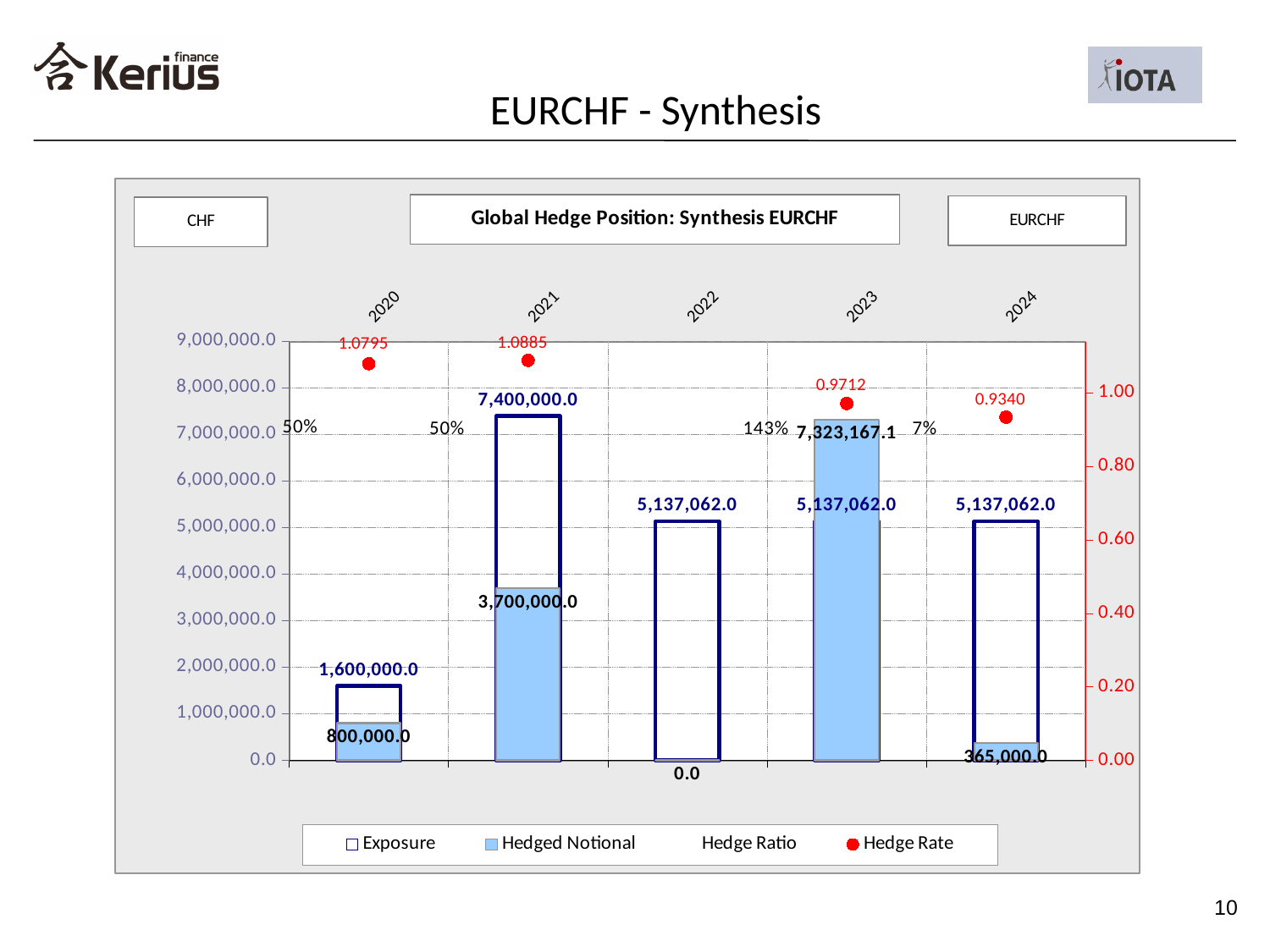
What is the Hedged Notional value for 2023? 7,323,167.1 Which year has the highest Exposure? 2021 How many years are shown on the x axis? 5 What is the Hedge Rate for 2020? 1.0795 Which is larger, the Hedged Notional in 2021 or in 2024? 2021 What is the difference between the Exposure in 2021 and the Exposure in 2020? 5,800,000.0 Which year has the lowest Hedged Notional? 2022 What is the Hedged Notional value for 2024? 365,000.0 Which year has the highest Hedge Rate? 2021 What is the Exposure value for 2021? 7,400,000.0 What is the title of the chart? Global Hedge Position: Synthesis EURCHF How many series does the legend list? 4